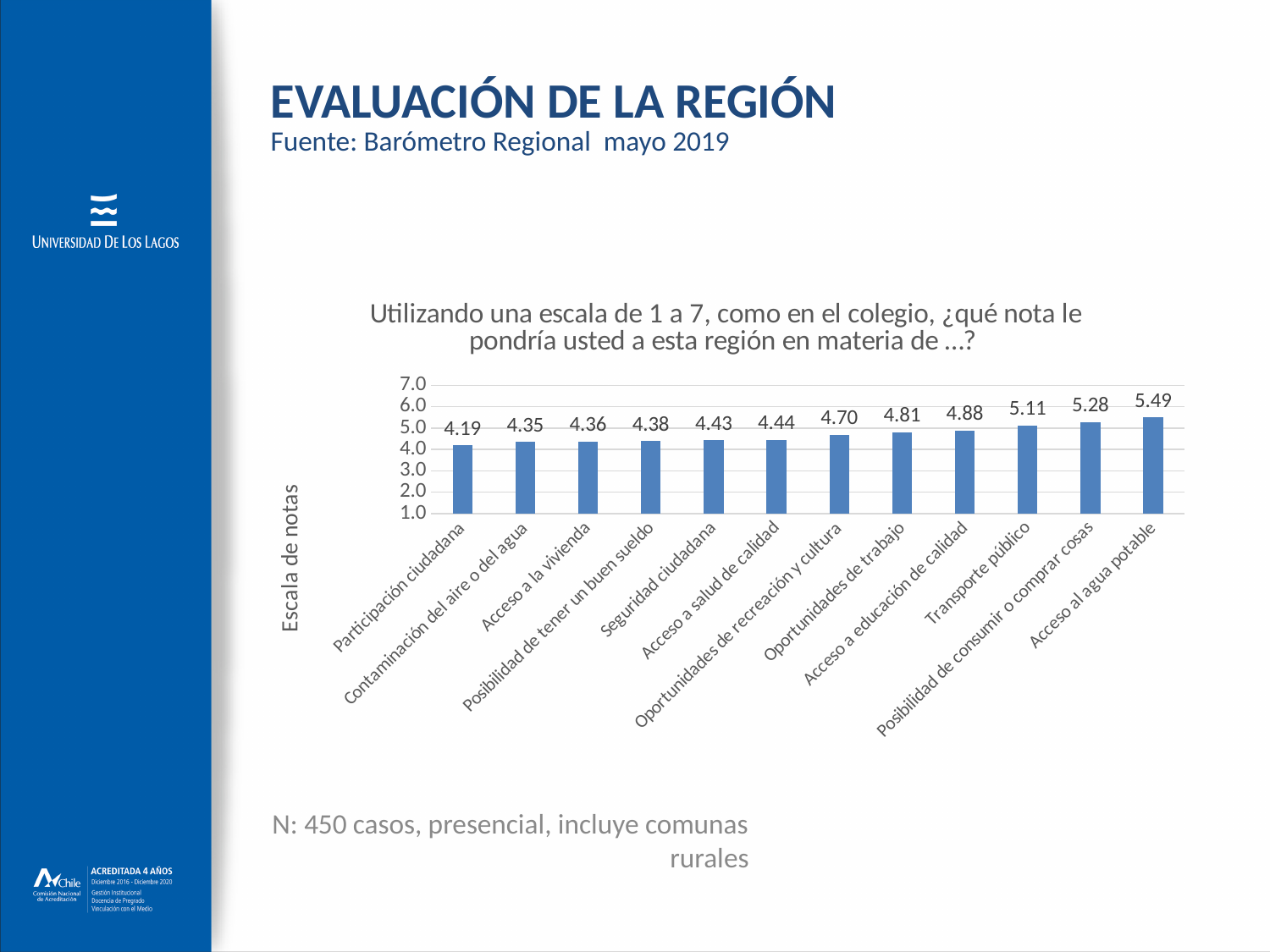
How many categories are shown in the chart? 12 Which is larger, the value for Oportunidades de trabajo or the value for Oportunidades de recreación y cultura? Oportunidades de trabajo What is the value for Transporte público? 5.11 Which category has the lowest value? Participación ciudadana What is the label of the vertical axis? Escala de notas What is the difference between the values for Acceso al agua potable and Participación ciudadana? 1.30 Which category has the highest value? Acceso al agua potable What is the value for Seguridad ciudadana? 4.43 Is the value for Posibilidad de consumir o comprar cosas greater or less than 5.0? greater What is the value for Acceso al agua potable? 5.49 What kind of chart is shown on the slide? bar chart Do the values rise or fall from left to right along the x axis? rise